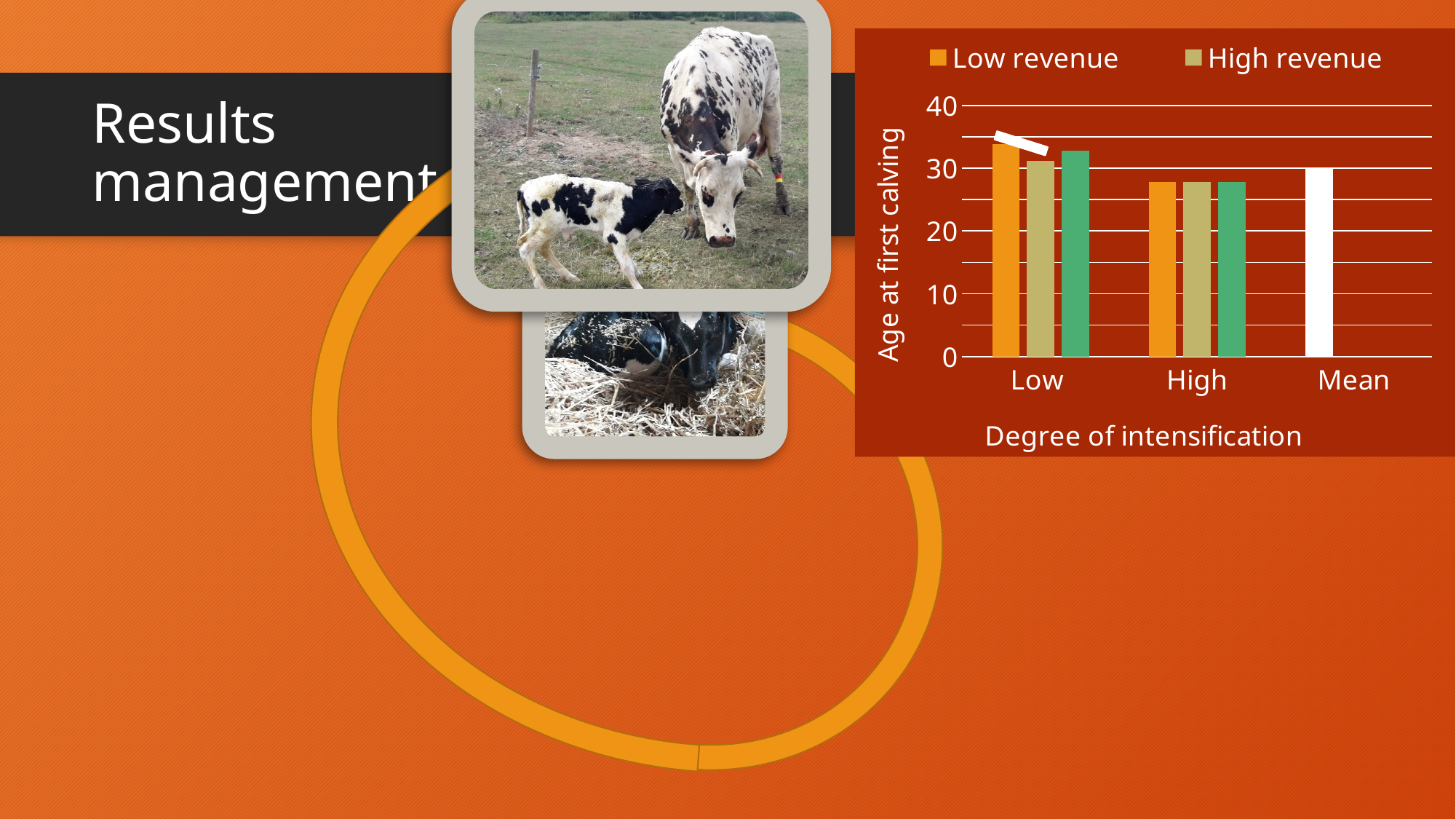
How many series does the chart's legend list? 2 How many categories are shown on the x axis of the chart? 3 Is the value for Mean greater or less than 40? less What is the title of the chart's horizontal axis? Degree of intensification Is the Low revenue value for the High degree of intensification greater or less than 30? less What is the title of the chart's vertical axis? Age at first calving Does the Low revenue value rise or fall from the Low to the High degree of intensification? fall Is the High revenue value for the High degree of intensification greater or less than 20? greater Which degree of intensification has the higher Low revenue value, Low or High? Low Which degree of intensification has the higher High revenue value, Low or High? Low What kind of chart is shown on the slide? bar chart